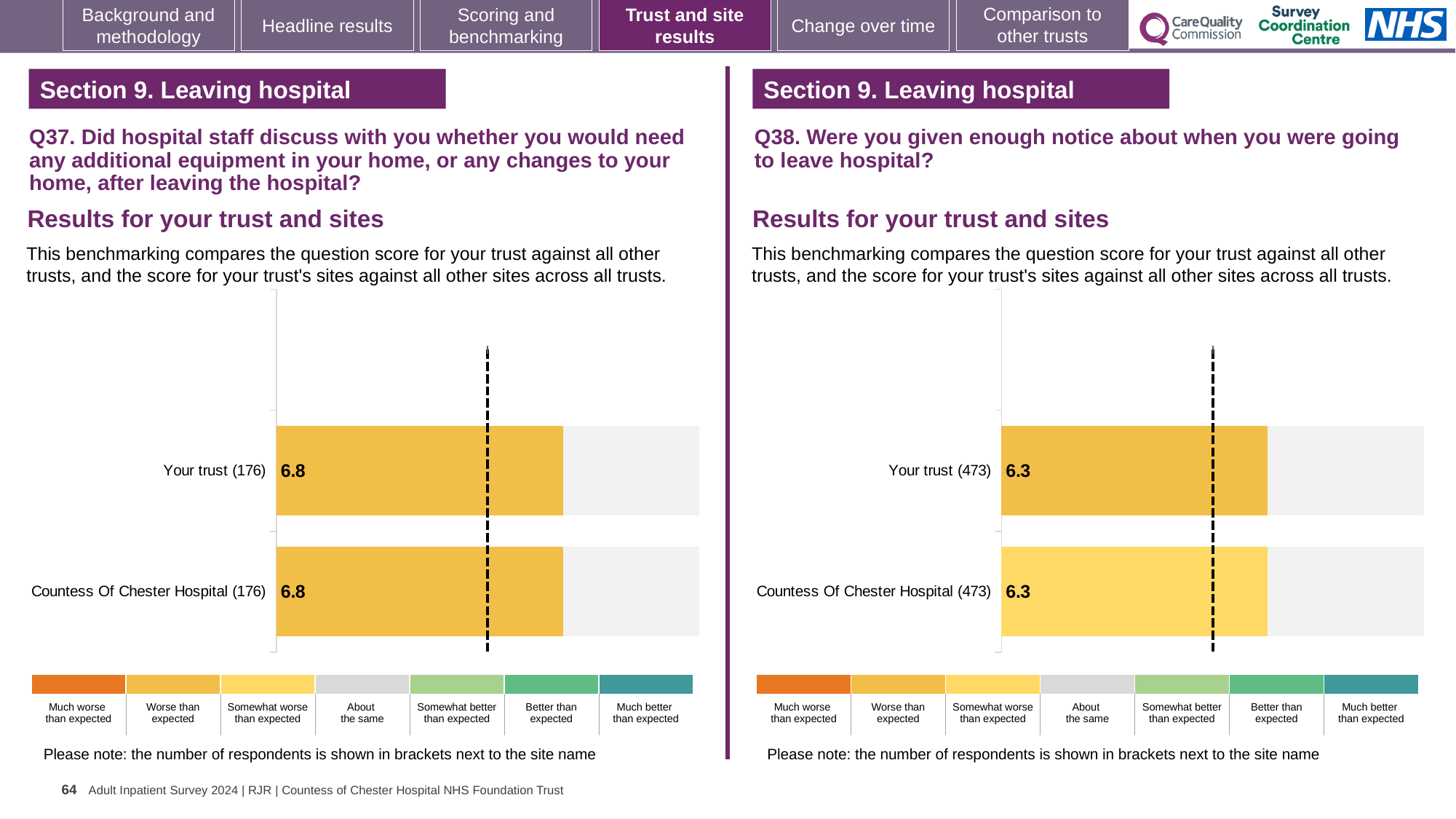
On the Q37 chart (left), what is the score for Countess Of Chester Hospital? 6.8 On the Q38 chart (right), what is the difference between the score for Your trust and the score for Countess Of Chester Hospital? 0.0 On the Q37 chart (left), how many respondents are shown in brackets for Your trust? 176 On the Q38 chart (right), which benchmark category does the colour of the Countess Of Chester Hospital bar correspond to in the key? Somewhat worse than expected What kind of chart is the Q38 chart (right)? Bar chart On the Q38 chart (right), what is the score for Countess Of Chester Hospital? 6.3 On the Q37 chart (left), what is the score for Your trust? 6.8 How many bars are plotted on the Q37 chart (left)? 2 On the Q38 chart (right), what is the score for Your trust? 6.3 How many bars are plotted on the Q38 chart (right)? 2 On the Q38 chart (right), how many respondents are shown in brackets for Countess Of Chester Hospital? 473 On the Q37 chart (left), what is the difference between the score for Your trust and the score for Countess Of Chester Hospital? 0.0